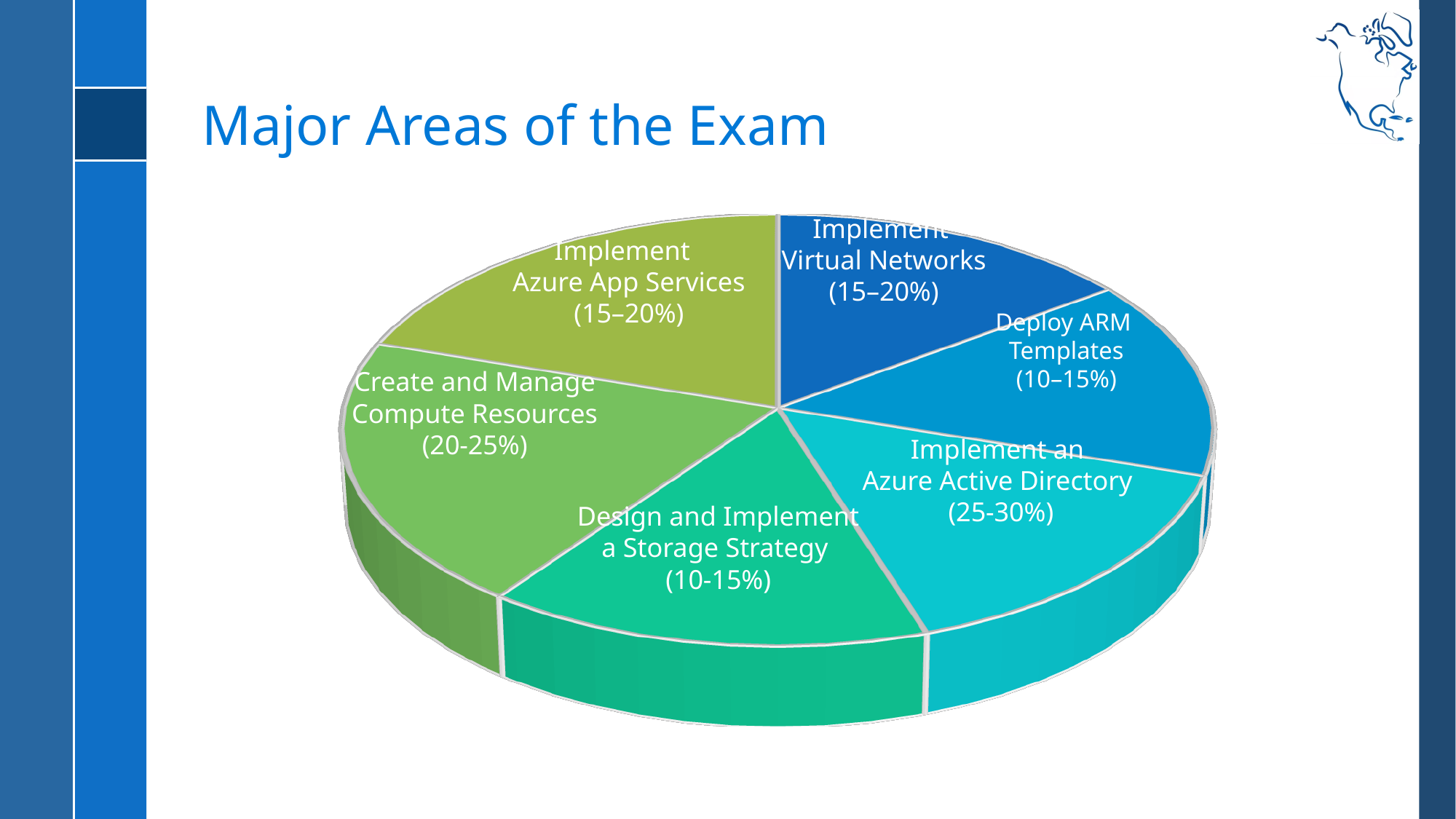
What percentage range is shown for Implement Azure App Services? 15–20% What kind of chart is shown on the slide? Pie chart What percentage range is shown for Implement Virtual Networks? 15–20% What percentage range is shown for Implement an Azure Active Directory? 25-30% What is the title of the slide's chart? Major Areas of the Exam Which has the larger share: Implement an Azure Active Directory or Design and Implement a Storage Strategy? Implement an Azure Active Directory How many slices does the pie chart have? 6 Which has the larger share: Create and Manage Compute Resources or Deploy ARM Templates? Create and Manage Compute Resources Which exam area has the largest share of the pie? Implement an Azure Active Directory What percentage range is shown for Create and Manage Compute Resources? 20-25% What percentage range is shown for Design and Implement a Storage Strategy? 10-15% What percentage range is shown for Deploy ARM Templates? 10–15%